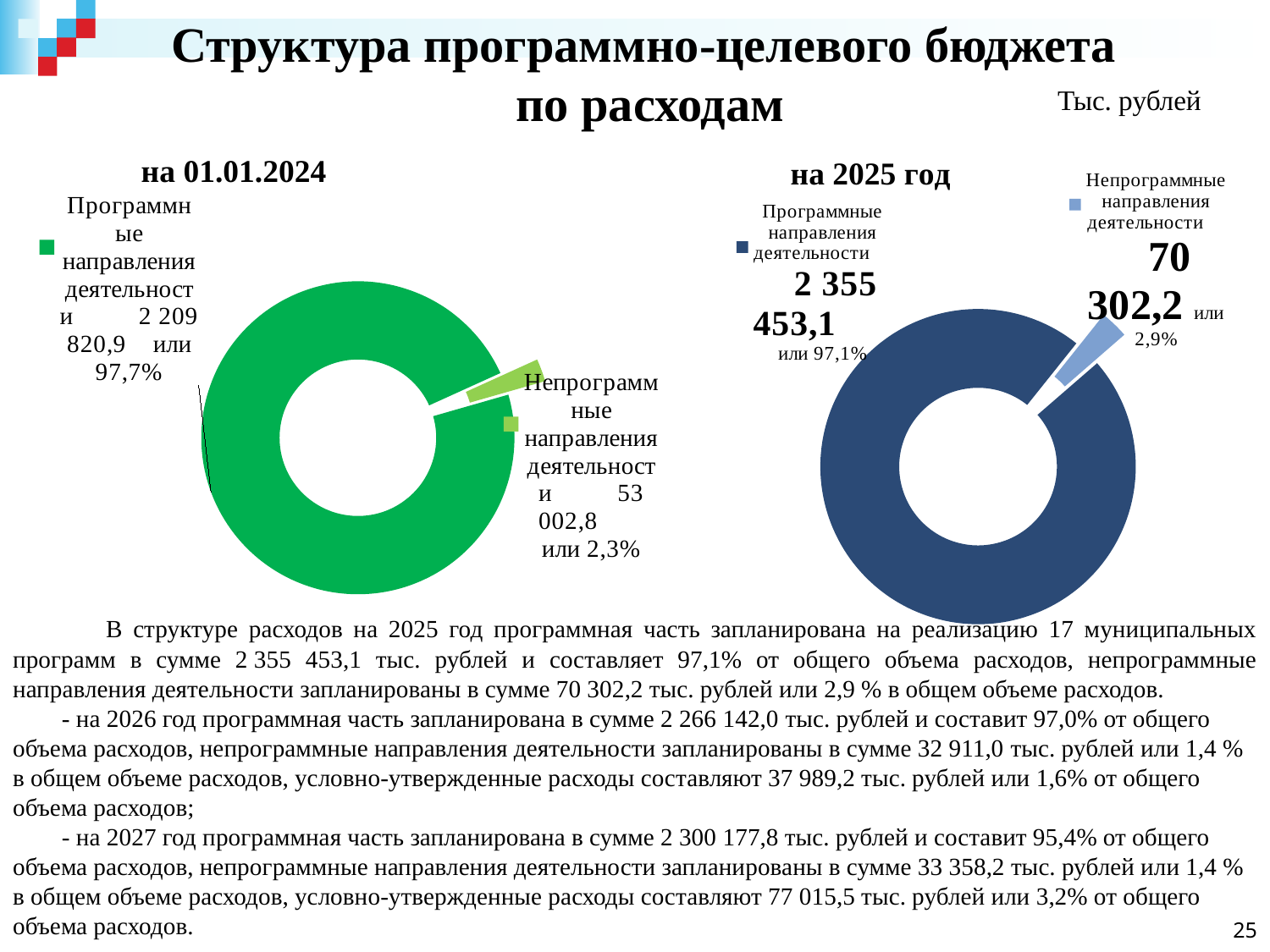
В каких единицах измерения приведены значения на диаграммах? Тыс. рублей На диаграмме «на 2025 год» какая категория имеет наименьшее значение? Непрограммные направления деятельности На диаграмме «на 2025 год» какое значение указано для непрограммных направлений деятельности? 70 302,2 Какого типа диаграммы показаны на слайде? Кольцевые (круговые) диаграммы На диаграмме «на 2025 год» какая доля приходится на программные направления деятельности? 97,1% На диаграмме «на 01.01.2024» какая категория имеет наибольшее значение? Программные направления деятельности На диаграмме «на 2025 год» какое значение указано для программных направлений деятельности? 2 355 453,1 На диаграмме «на 01.01.2024» какое значение указано для программных направлений деятельности? 2 209 820,9 На диаграмме «на 01.01.2024» какое значение указано для непрограммных направлений деятельности? 53 002,8 На диаграмме «на 01.01.2024» какая доля приходится на непрограммные направления деятельности? 2,3% Сколько категорий показано на диаграмме «на 2025 год»? 2 Что больше: непрограммные направления деятельности на 01.01.2024 или на 2025 год? На 2025 год